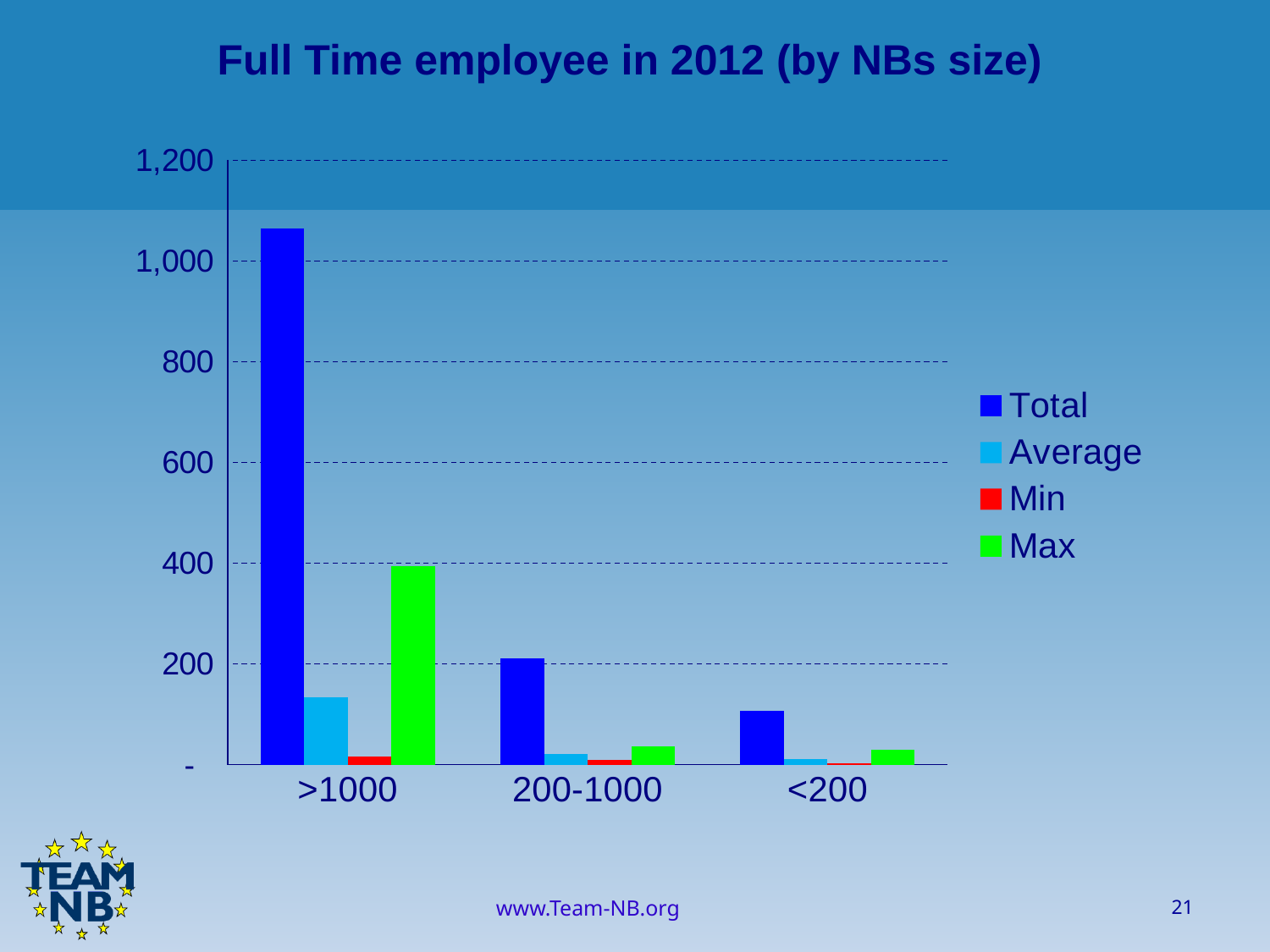
Which NB size category has the highest Total value? >1000 Which has the larger Total value, 200-1000 or <200? 200-1000 Is the Total value for >1000 greater or less than 1,000? greater How many series does the legend list? 4 What kind of chart is shown on the slide? bar chart What colour represents the Min series in the legend? red For the >1000 category, which is larger, the Average or the Max value? Max Is the Max value for >1000 greater or less than 200? greater Which NB size category has the lowest Total value? <200 How many NB size categories are shown on the x axis? 3 Do the Total values rise or fall moving from >1000 to <200 along the x axis? fall Is the Total value for 200-1000 greater or less than 400? less